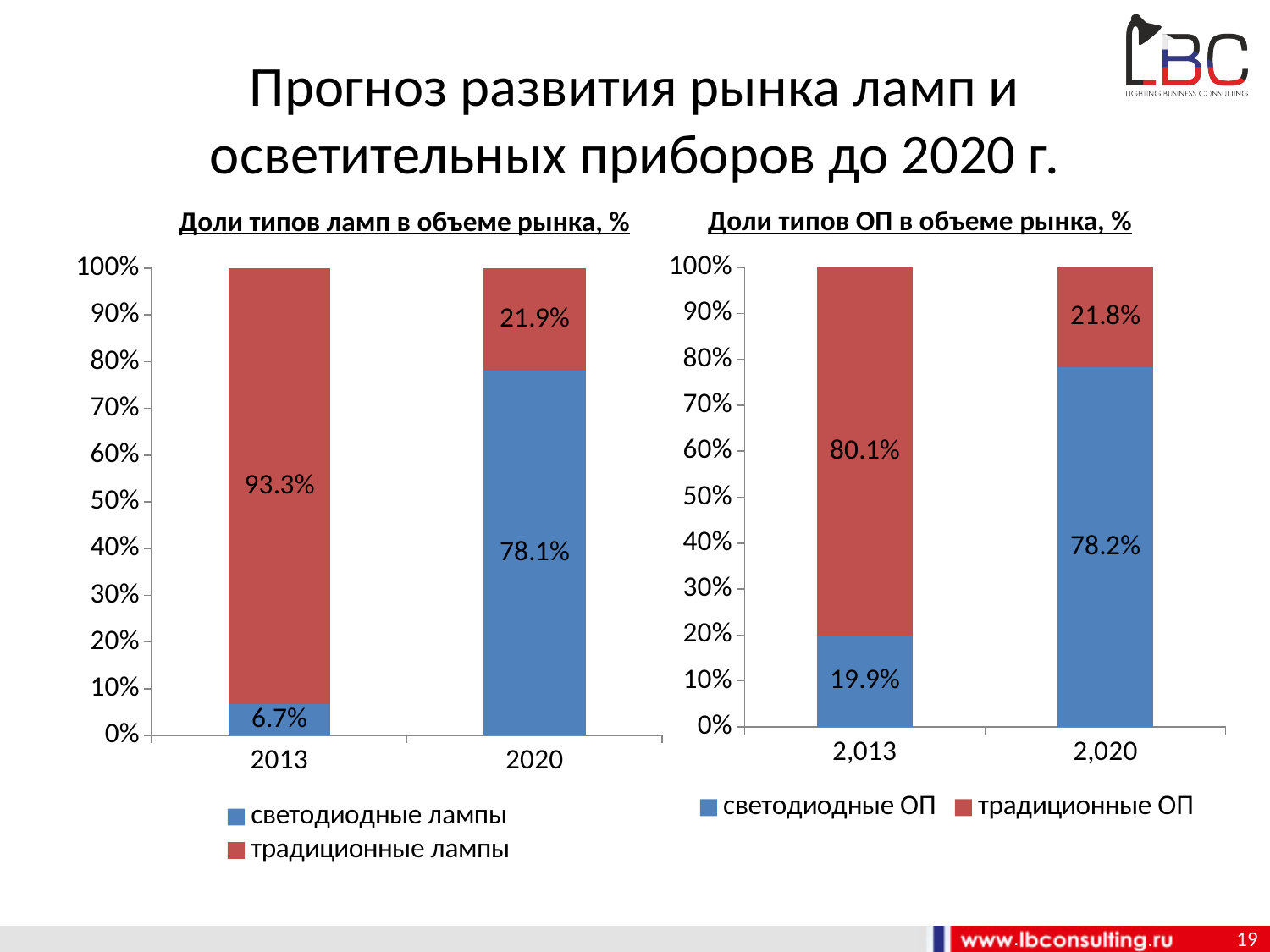
In the chart 'Доли типов ОП в объеме рынка, %', what is the value for традиционные ОП in 2,020? 21.8% In the chart 'Доли типов ОП в объеме рынка, %', what is the value for светодиодные ОП in 2,013? 19.9% What type of chart is 'Доли типов ОП в объеме рынка, %'? stacked bar chart In the chart 'Доли типов ОП в объеме рынка, %', what is the difference between традиционные ОП in 2,013 and in 2,020? 58.3% In the chart 'Доли типов ламп в объеме рынка, %', which is larger in 2020: светодиодные лампы or традиционные лампы? светодиодные лампы In the chart 'Доли типов ОП в объеме рынка, %', which year has the higher share of светодиодные ОП? 2,020 In the chart 'Доли типов ламп в объеме рынка, %', by how much does the share of светодиодные лампы in 2020 exceed its share in 2013? 71.4% In the chart 'Доли типов ламп в объеме рынка, %', does the share of светодиодные лампы rise or fall from 2013 to 2020? rise In the chart 'Доли типов ламп в объеме рынка, %', what is the value for традиционные лампы in 2020? 21.9% How many series does the legend of the chart 'Доли типов ламп в объеме рынка, %' list? 2 In the chart 'Доли типов ОП в объеме рынка, %', what is the total of the stacked bar for 2,013? 100% In the chart 'Доли типов ламп в объеме рынка, %', what is the value for светодиодные лампы in 2013? 6.7%